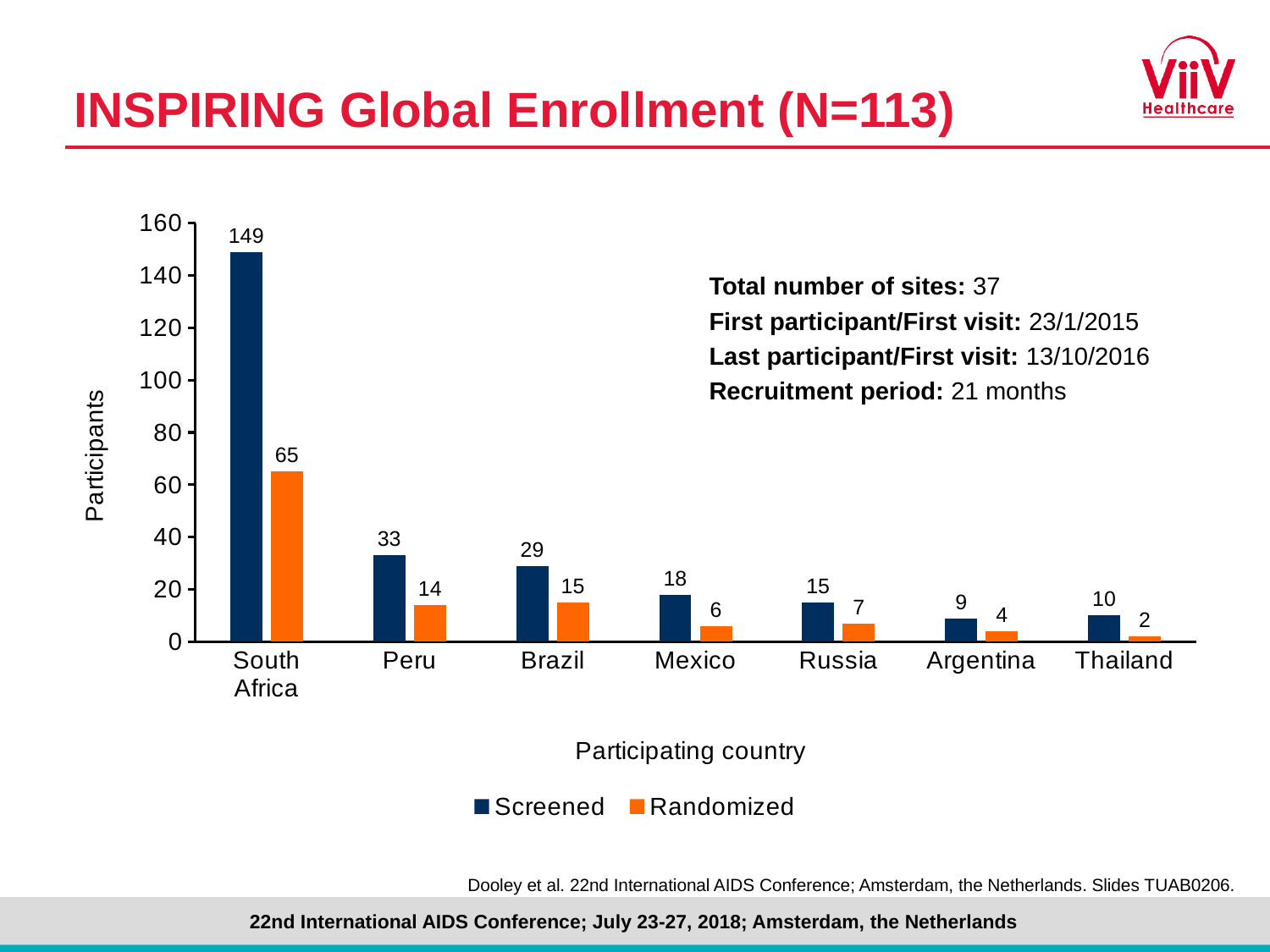
Which is larger: the number screened in Mexico or the number screened in Russia? Mexico What is the difference between screened and randomized participants in South Africa? 84 How many participants were randomized in Brazil? 15 What is the label of the y axis? Participants What is the difference between the number screened in Peru and the number screened in Brazil? 4 How many countries are shown on the x axis? 7 How many participants were randomized in Thailand? 2 Which country has the lowest number of randomized participants? Thailand How many series does the legend list? 2 What kind of chart is shown on the slide? Bar chart How many participants were screened in South Africa? 149 Which country has the highest number of screened participants? South Africa